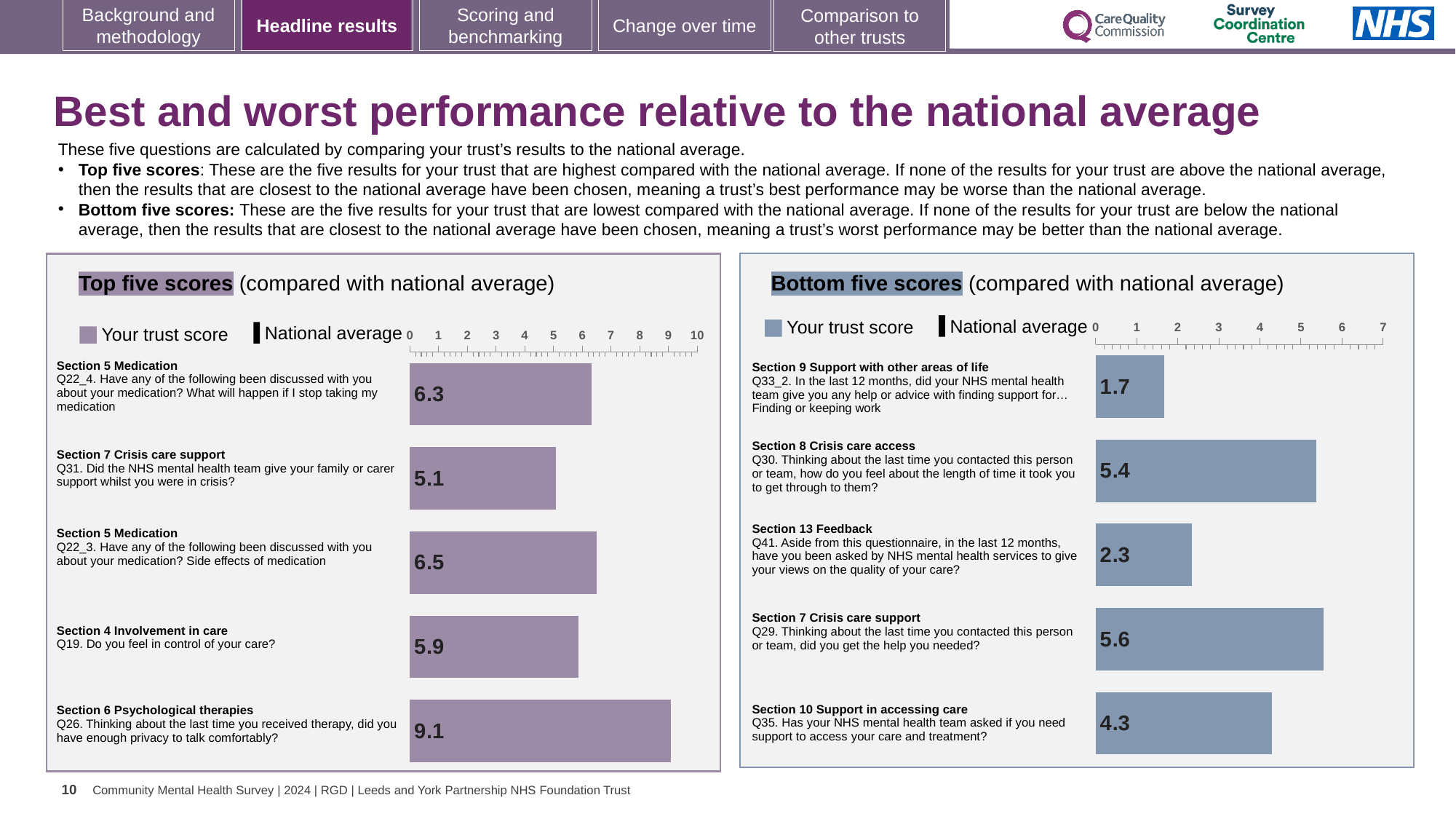
In the Top five scores chart, what is the trust score for Q26 (enough privacy to talk comfortably during therapy)? 9.1 In the Top five scores chart, which question has the lowest trust score? Q31 In the Bottom five scores chart, what is the trust score for Q33_2 (help or advice with finding or keeping work)? 1.7 In the Bottom five scores chart, which question has the highest trust score? Q29 What type of chart is used for the Top five scores? Bar chart In the Top five scores chart, what is the trust score for Q19 (Do you feel in control of your care?)? 5.9 In the Top five scores chart, what is the difference between the trust scores for Q26 and Q31? 4.0 In the Bottom five scores chart, which has the larger trust score: Q30 or Q41? Q30 In the Top five scores chart, which question has the highest trust score? Q26 In the Bottom five scores chart, which question has the lowest trust score? Q33_2 How many bars are shown in the Bottom five scores chart? 5 In the Bottom five scores chart, what is the trust score for Q35 (asked if you need support to access your care and treatment)? 4.3